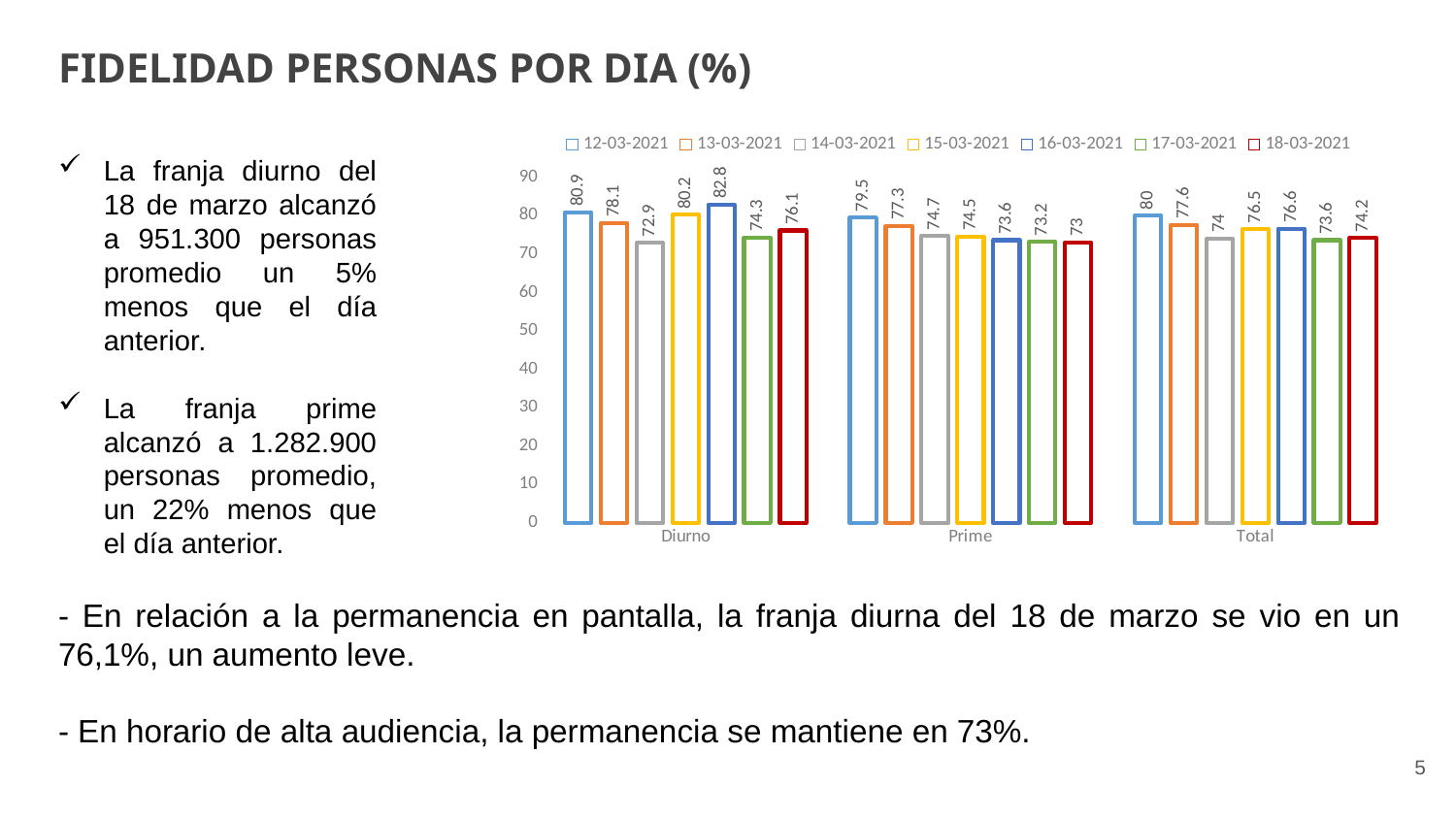
Which date has the lowest value in the Prime category? 18-03-2021 Which is larger in the Total category: the value for 13-03-2021 or the value for 17-03-2021? 13-03-2021 Is the value for 14-03-2021 in the Diurno category greater or less than 80? less What is the value for 18-03-2021 in the Diurno category? 76.1 How many categories are shown on the x axis? 3 What is the value for 16-03-2021 in the Prime category? 73.6 What is the difference between the 16-03-2021 and 14-03-2021 values in the Diurno category? 9.9 Which date has the highest value in the Diurno category? 16-03-2021 What is the title of the slide containing the chart? FIDELIDAD PERSONAS POR DIA (%) How many series does the legend list? 7 What is the value for 12-03-2021 in the Total category? 80 What kind of chart is shown on the slide? bar chart